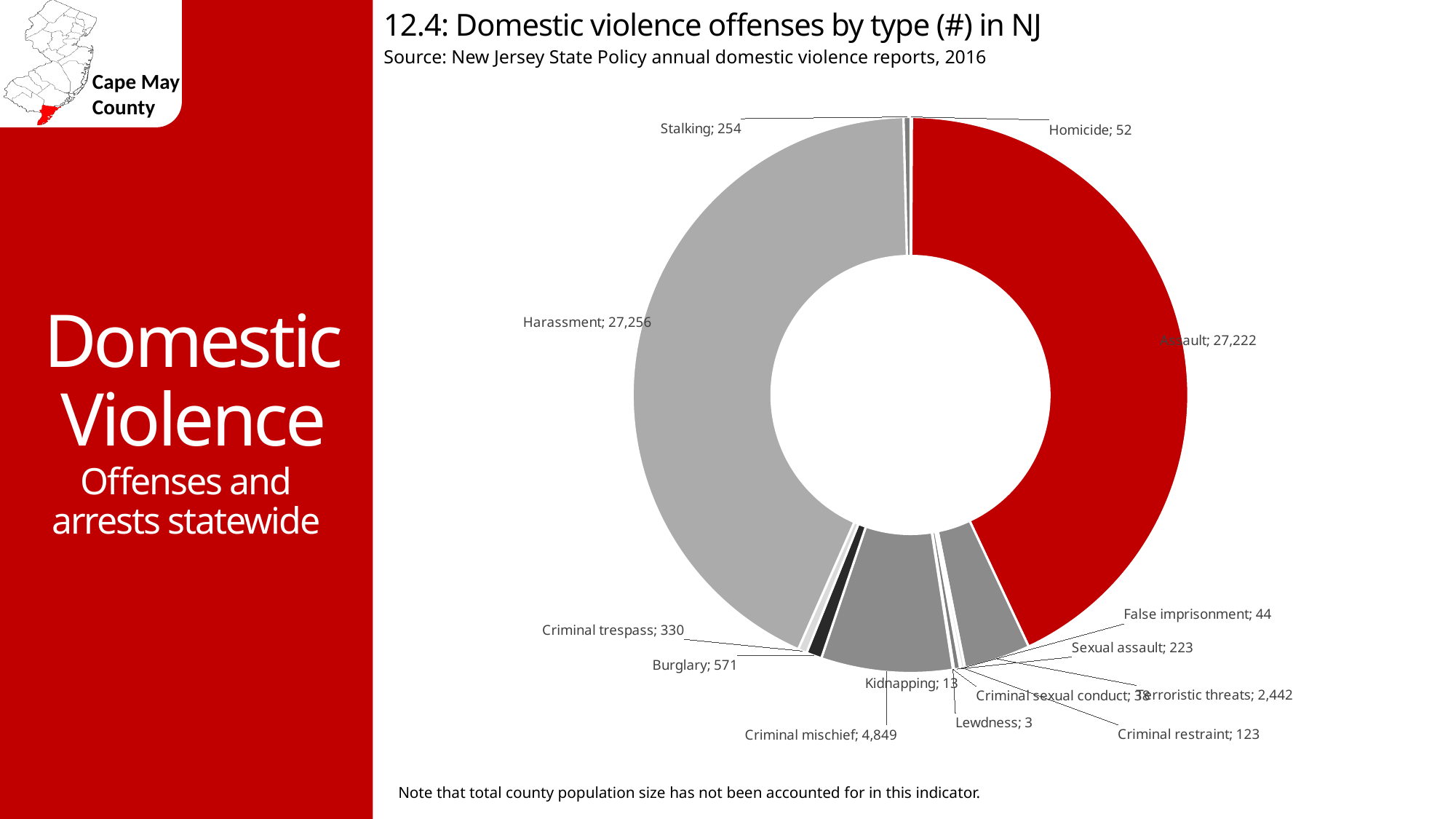
What kind of chart is shown on the slide? doughnut chart What is the difference between Criminal mischief and Terroristic threats? 2,407 What is the difference between Burglary and Criminal trespass? 241 What is the value for Harassment? 27,256 What is the value for Homicide? 52 What is the value for Terroristic threats? 2,442 How many offense types are shown in the chart? 14 Which is larger, Stalking or Sexual assault? Stalking What is the title of the chart? 12.4: Domestic violence offenses by type (#) in NJ What is the value for Assault? 27,222 Which offense type has the lowest value? Lewdness What is the value for Criminal mischief? 4,849